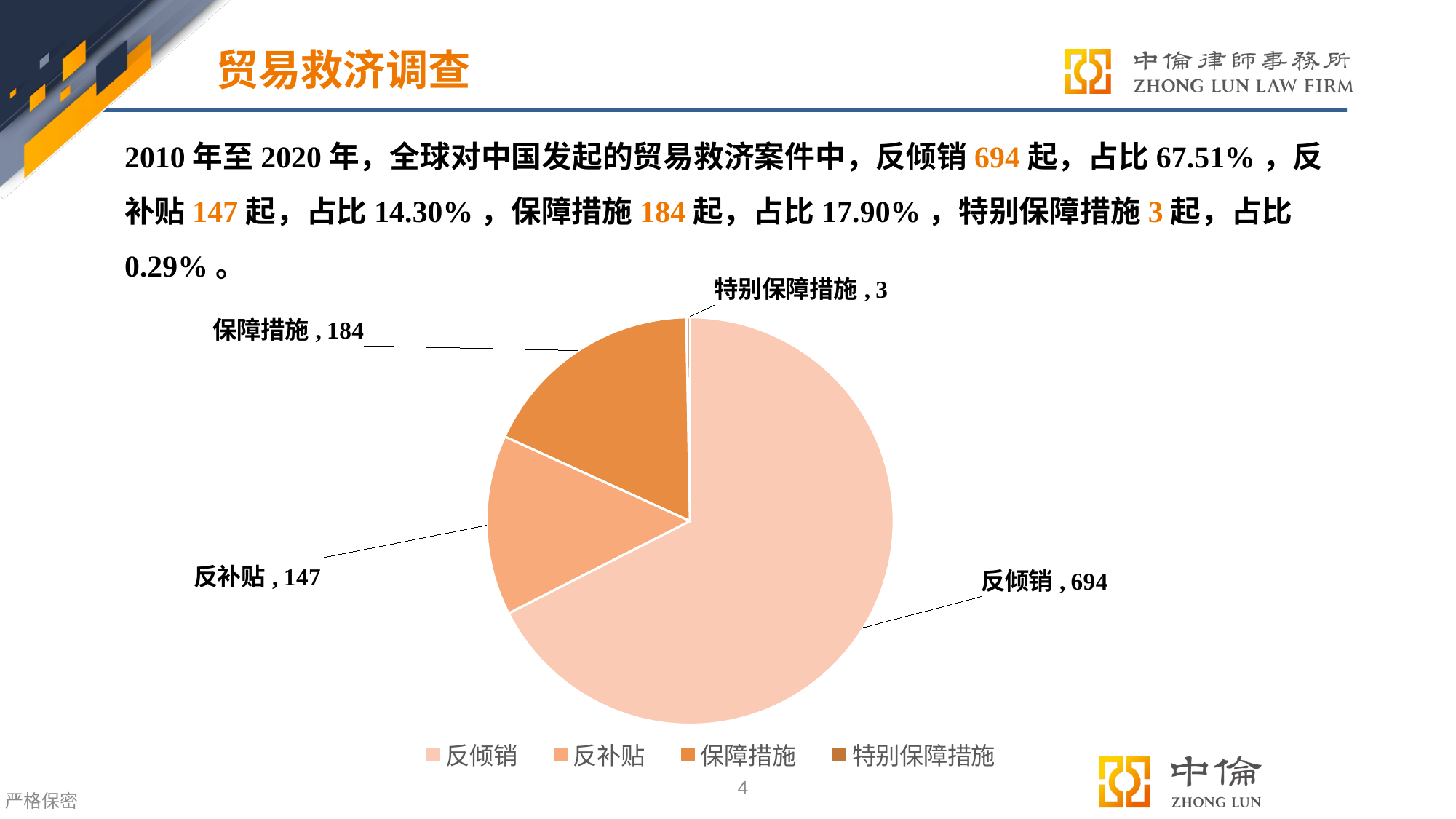
Which is larger in the pie chart, 保障措施 or 反补贴? 保障措施 What is the value shown for 反倾销 in the pie chart? 694 Which category has the smallest slice in the pie chart? 特别保障措施 How many slices does the pie chart have? 4 What kind of chart is shown on the slide? Pie chart What is the difference between the values for 保障措施 and 反补贴 in the pie chart? 37 What is the value shown for 特别保障措施 in the pie chart? 3 What is the value shown for 反补贴 in the pie chart? 147 Which category has the largest slice in the pie chart? 反倾销 How many entries does the legend of the pie chart list? 4 What is the value shown for 保障措施 in the pie chart? 184 What share of the pie does 反倾销 represent, according to the slide? 67.51%